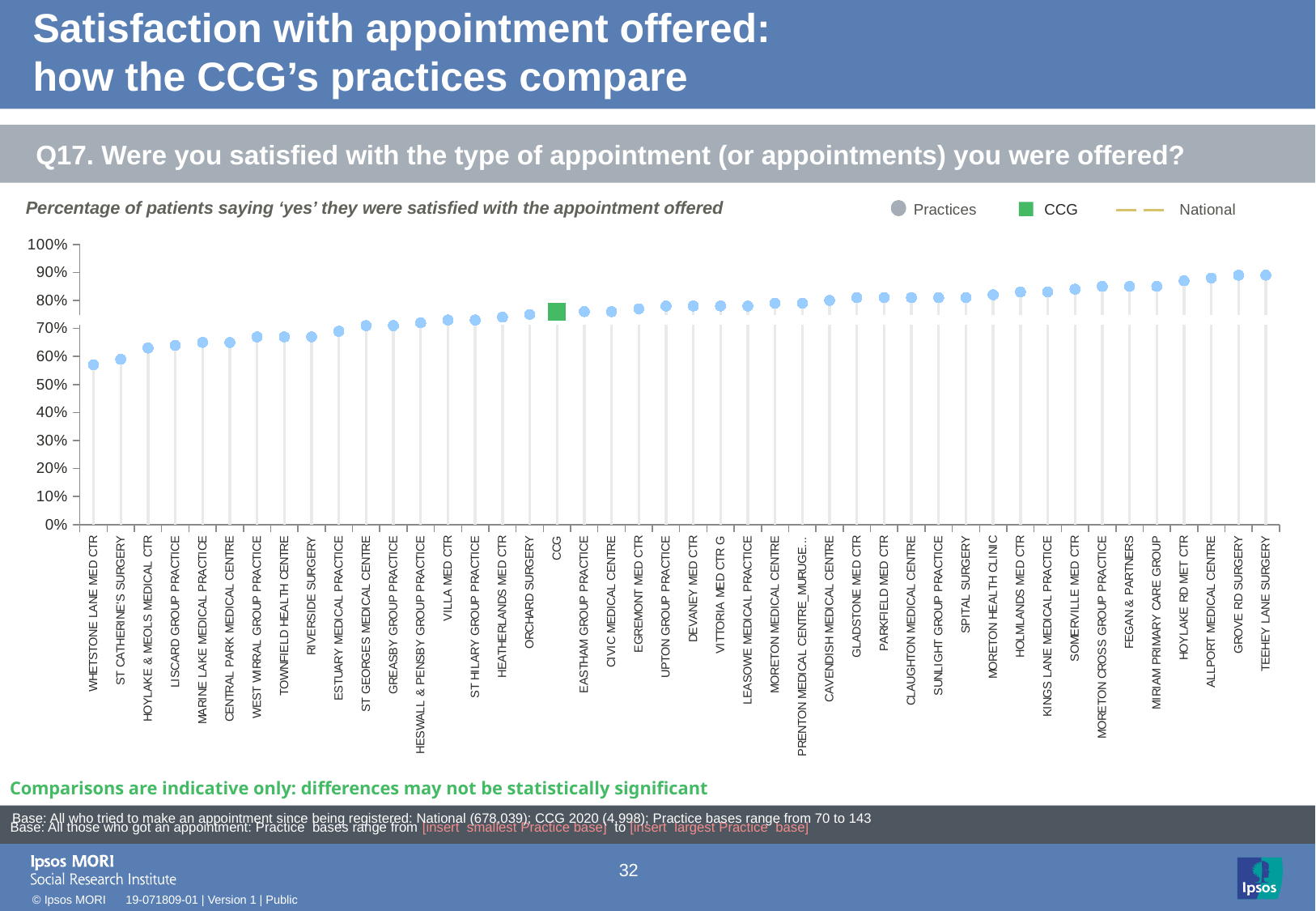
Which is higher, the value for TEEHEY LANE SURGERY or the value for WHETSTONE LANE MED CTR? TEEHEY LANE SURGERY What is the highest value shown on the y axis? 100% How many entries does the legend list? 3 Is the value for WHETSTONE LANE MED CTR greater or less than 60%? less What colour is the marker used for the CCG in the chart? green Is the value for TEEHEY LANE SURGERY greater or less than 80%? greater Is the CCG value greater or less than 70%? greater Which is higher, the value for HOYLAKE & MEOLS MEDICAL CTR or the value for CAVENDISH MEDICAL CENTRE? CAVENDISH MEDICAL CENTRE Do the values rise or fall moving from left to right along the x axis? rise Which practice has the lowest percentage of patients satisfied with the appointment offered? WHETSTONE LANE MED CTR